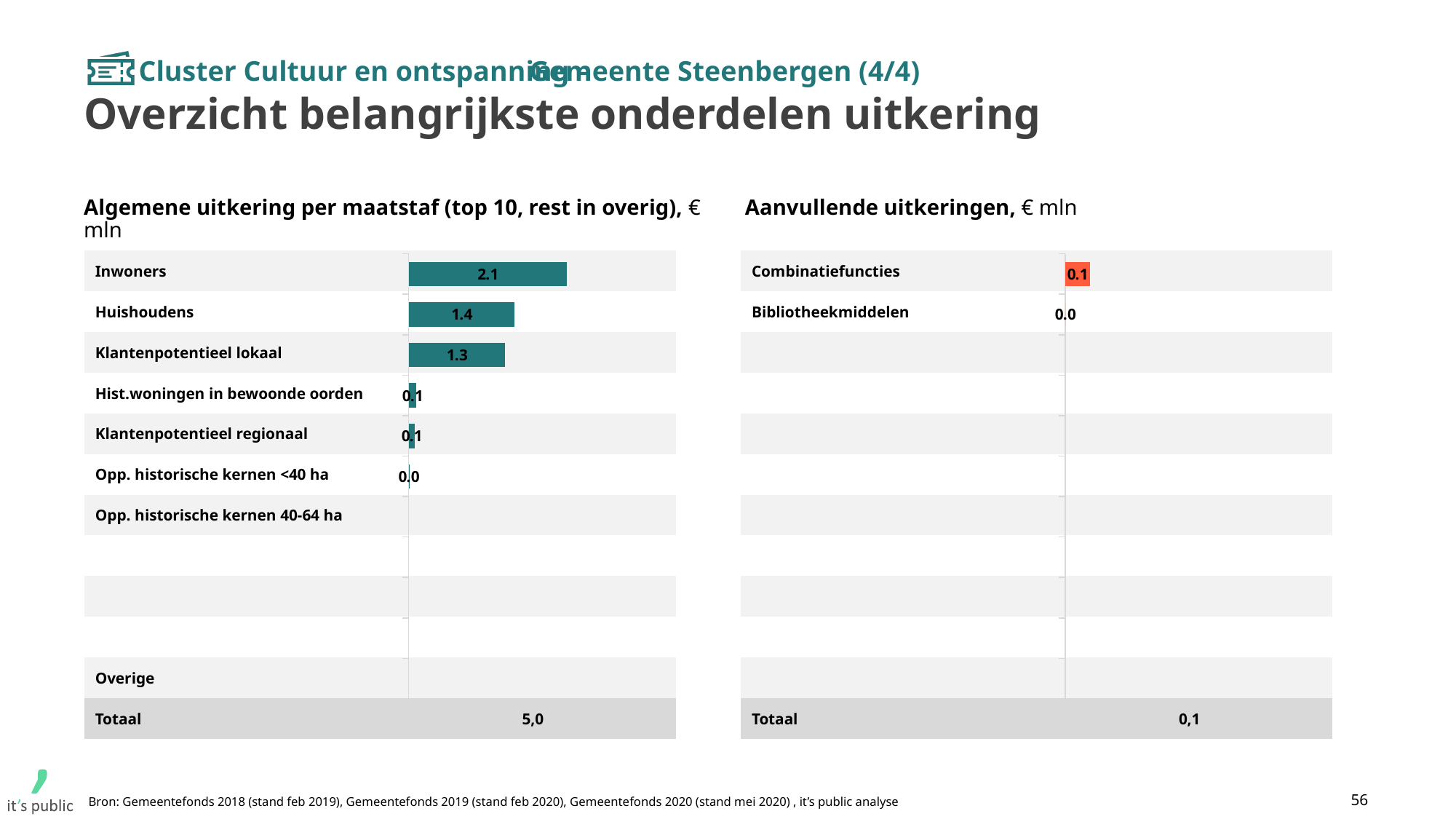
In the 'Aanvullende uitkeringen' chart, how many categories are labelled? 2 In the 'Algemene uitkering per maatstaf' chart, which is larger: Huishoudens or Klantenpotentieel lokaal? Huishoudens What kind of chart is the 'Algemene uitkering per maatstaf' chart? Bar chart In the 'Algemene uitkering per maatstaf' chart, what is the value for Klantenpotentieel lokaal? 1.3 In the 'Aanvullende uitkeringen' chart, what is the value for Combinatiefuncties? 0.1 In the 'Algemene uitkering per maatstaf' chart, what is the value for Inwoners? 2.1 In the 'Aanvullende uitkeringen' chart, what is the value for Bibliotheekmiddelen? 0.0 In the 'Algemene uitkering per maatstaf' chart, what is the difference between Inwoners and Huishoudens? 0.7 In the 'Algemene uitkering per maatstaf' chart, what is the value for Huishoudens? 1.4 In the 'Algemene uitkering per maatstaf' chart, what is the value for Klantenpotentieel regionaal? 0.1 In the 'Algemene uitkering per maatstaf' chart, which category has the highest value? Inwoners In the 'Algemene uitkering per maatstaf' chart, what is the Totaal value shown? 5,0